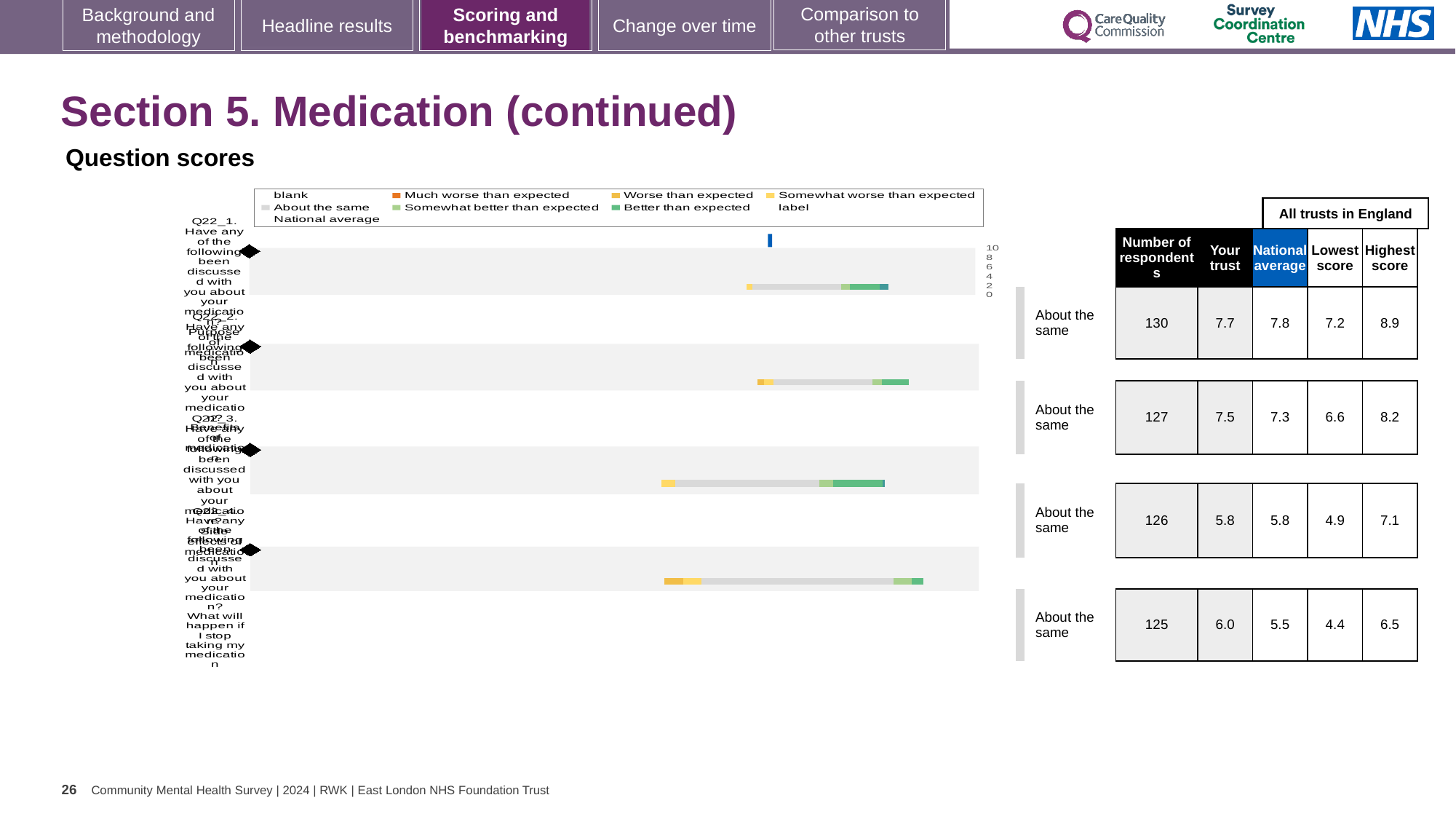
Which question row has the highest 'Your trust' score? the first row (7.7) How many question rows (bars) are plotted in the chart? 4 Which question row has the lowest 'Your trust' score? the third row (5.8) What is the difference between 'Your trust' and 'National average' for the second question row? 0.2 For the fourth question row, which is larger: the 'Your trust' score or the 'National average'? Your trust (6.0) What benchmark label is shown next to each of the four question rows? About the same What kind of chart is shown under 'Question scores'? bar chart What is the 'National average' for the second question row (127 respondents)? 7.3 What is the 'Highest score' for the fourth question row (125 respondents)? 6.5 What is the difference between the 'Highest score' and 'Lowest score' for the first question row? 1.7 How many respondents are listed for the third question row? 126 What is the 'Your trust' score for the first question row (130 respondents)? 7.7